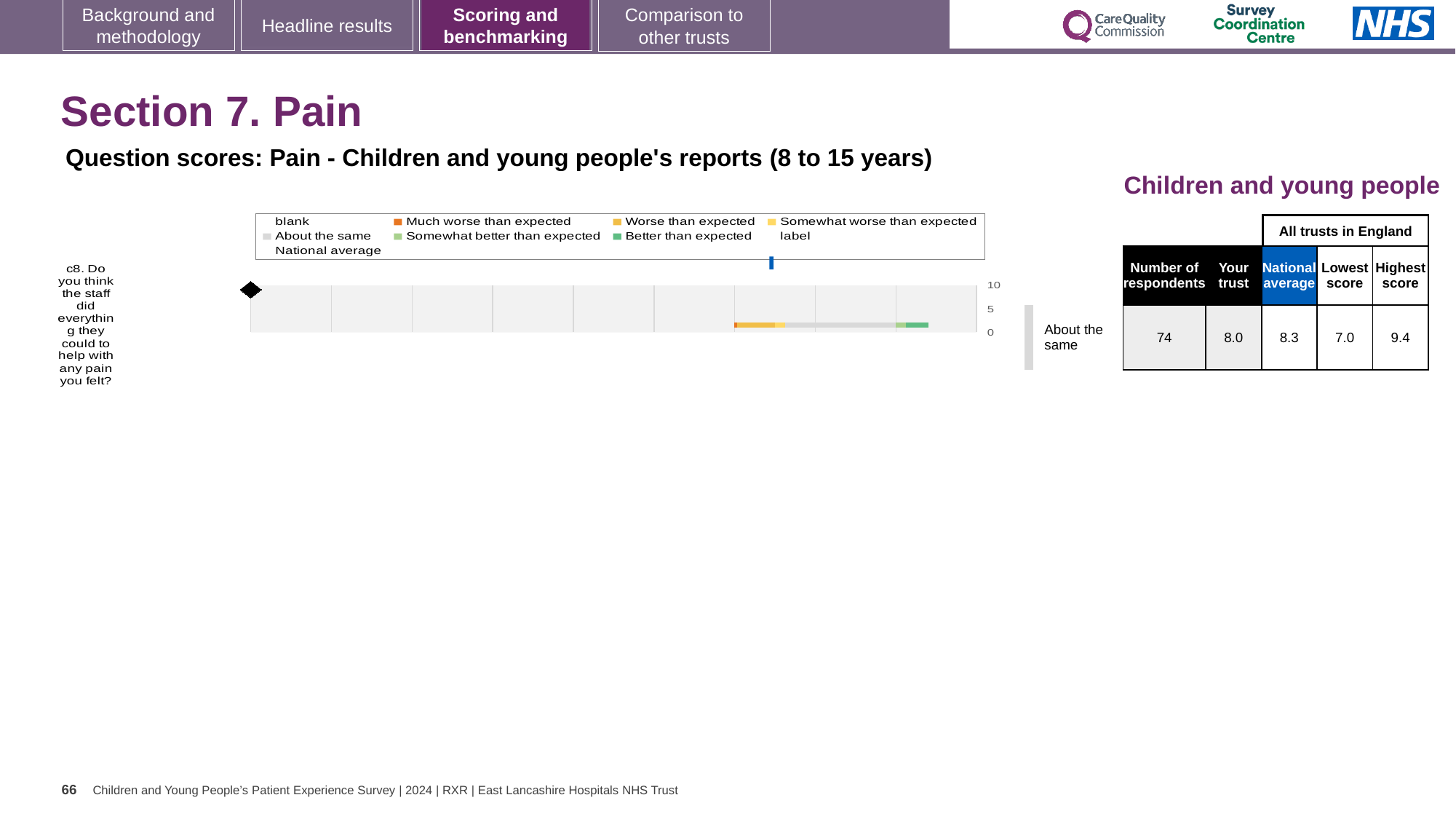
What kind of chart is used to show the question score for c8? Bar chart By how much does the national average exceed the 'Your trust' score for question c8? 0.3 What is the difference between the highest score and the lowest score for question c8? 2.4 Which benchmarking category is the trust's result for question c8 placed in? About the same What is the highest score among all trusts in England for question c8? 9.4 Which is higher for question c8: the 'Your trust' score or the national average? National average How many survey questions are plotted on the chart? 1 What is the national average score for question c8? 8.3 What is the 'Your trust' score for question c8 (Do you think the staff did everything they could to help with any pain you felt?)? 8.0 What is the maximum value shown on the chart's score axis? 10 What is the lowest score among all trusts in England for question c8? 7.0 How many respondents answered question c8? 74